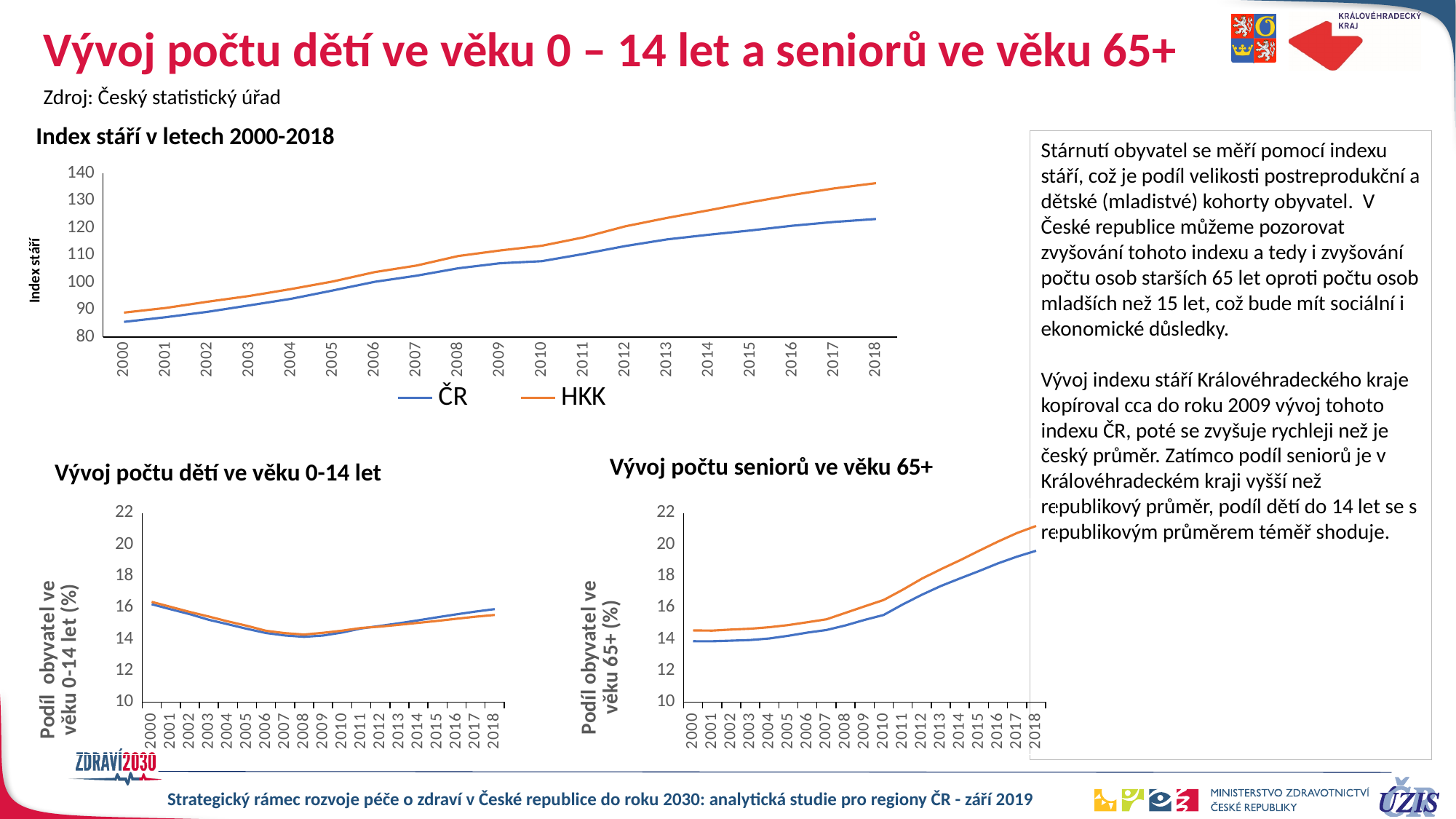
On the 'Index stáří v letech 2000-2018' chart, do the values for HKK rise or fall from 2000 to 2018? rise On the 'Vývoj počtu dětí ve věku 0-14 let' chart, is the value in 2000 greater or less than 18? less How many years are shown on the x axis of the 'Index stáří v letech 2000-2018' chart? 19 On the 'Vývoj počtu seniorů ve věku 65+' chart, do the values rise or fall from 2000 to 2018? rise On the 'Vývoj počtu seniorů ve věku 65+' chart, is the value of the orange line in 2018 greater or less than 20? greater What are the two legend entries on the 'Index stáří v letech 2000-2018' chart? ČR and HKK On the 'Index stáří v letech 2000-2018' chart, which series has the higher value in 2018, ČR or HKK? HKK On the 'Index stáří v letech 2000-2018' chart, is the value for ČR in 2018 greater or less than 130? less What type of chart is the 'Index stáří v letech 2000-2018' chart? line chart How many series does the legend of the 'Index stáří v letech 2000-2018' chart list? 2 What is the title of the bottom-left chart? Vývoj počtu dětí ve věku 0-14 let